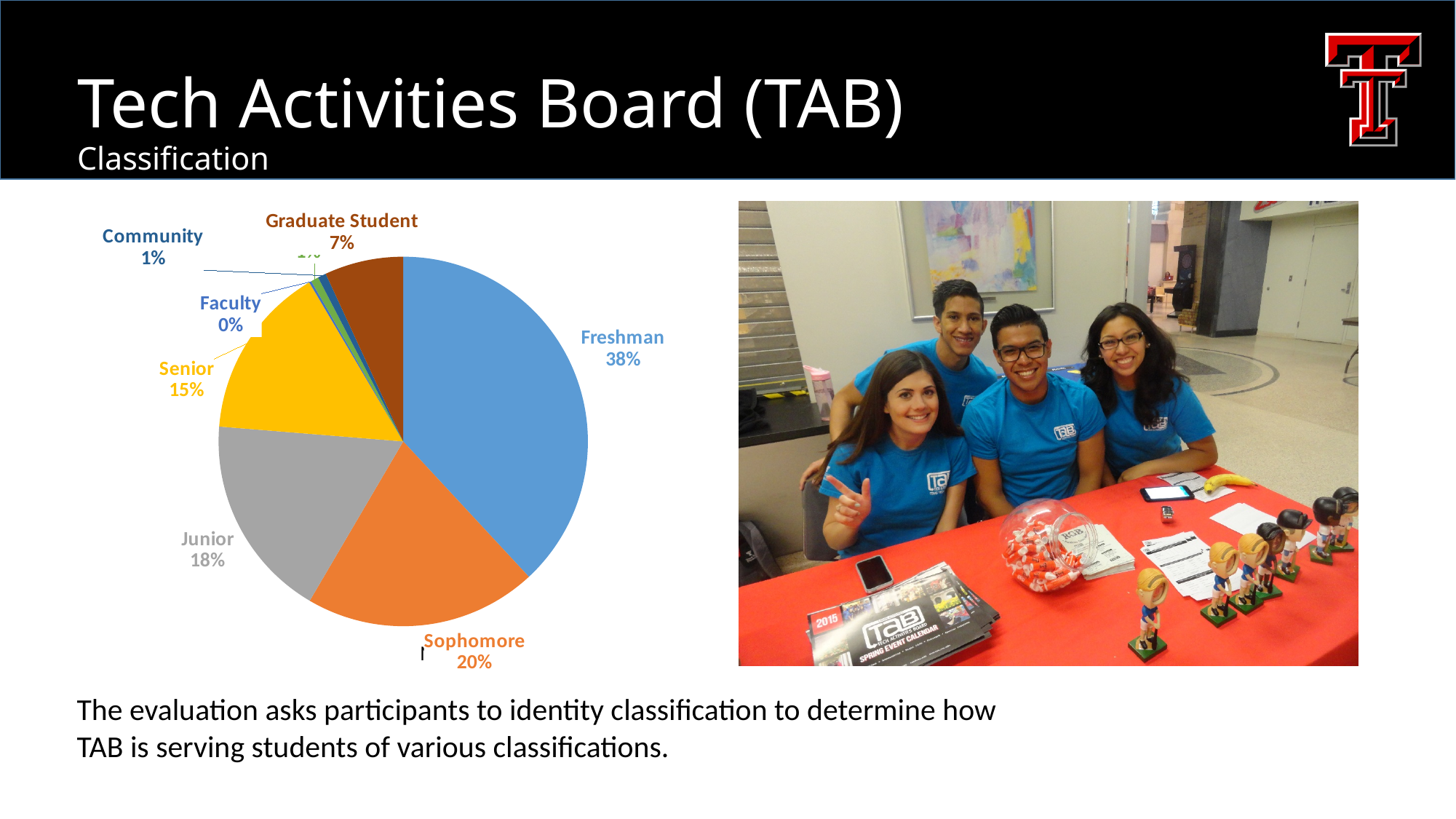
What percentage of participants are Community? 1% What percentage of participants are Junior? 18% What type of chart is shown on the slide? pie chart Which has a larger share, Junior or Senior? Junior What percentage of participants are Freshman? 38% What percentage of participants are Sophomore? 20% What percentage of participants are Faculty? 0% What percentage of participants are Senior? 15% What percentage of participants are Graduate Student? 7% What is the difference in percentage points between Freshman and Sophomore? 18 Which classification has the largest share of the pie? Freshman Which classification has the smallest share of the pie? Faculty